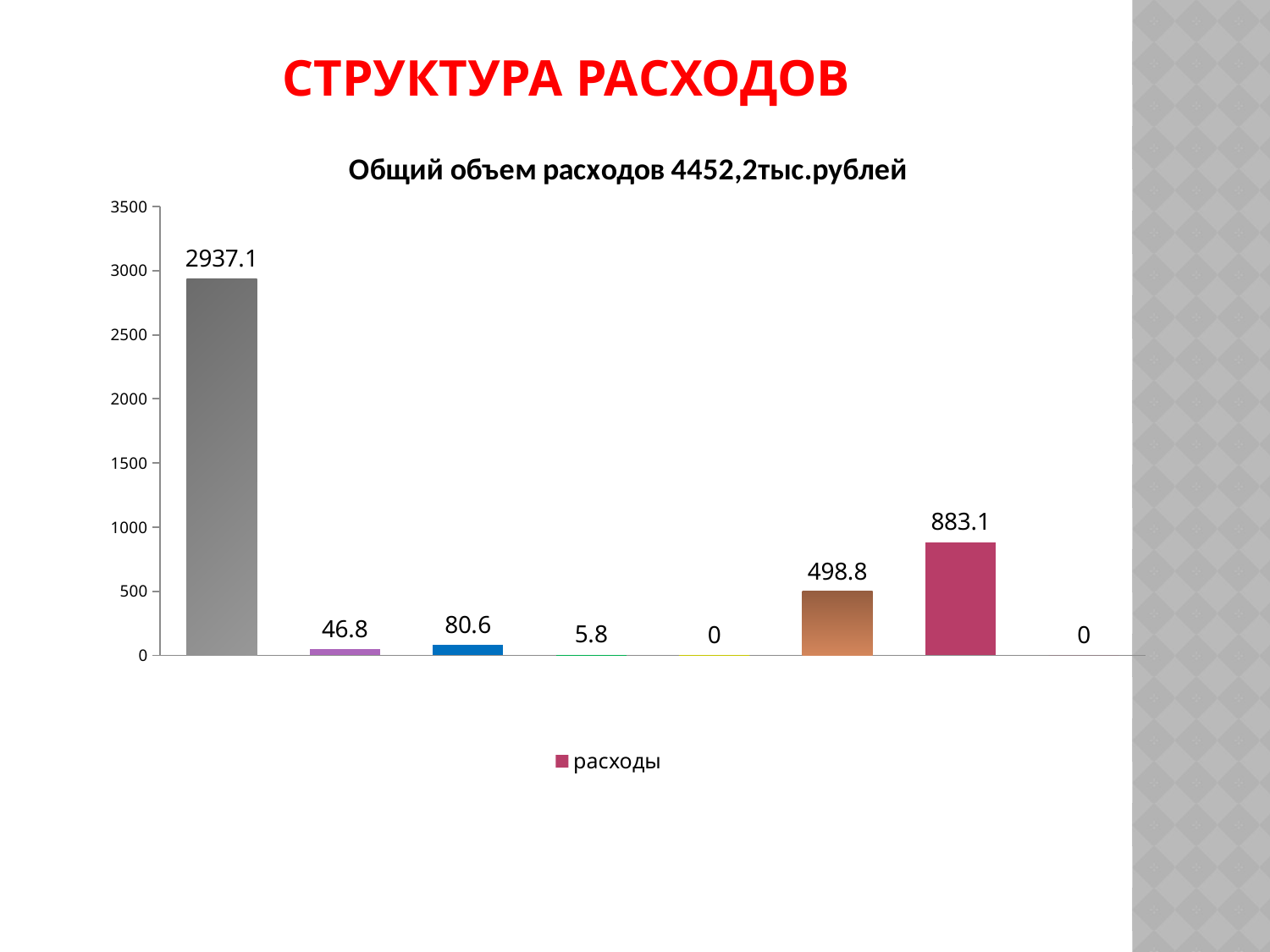
What is the value of the brown bar? 498.8 How many bars are plotted in the chart? 8 What is the value of the pink bar, the second bar from the right? 883.1 What kind of chart is shown on the slide? bar chart What is the value of the first bar from the left (the grey bar)? 2937.1 How many bars have a value of 0? 2 Which is larger, the blue bar or the purple bar? the blue bar How many series does the legend list? 1 What is the legend entry shown below the chart? расходы What is the value of the tallest bar in the chart? 2937.1 What is the difference between the pink bar (883.1) and the brown bar (498.8)? 384.3 Is the value of the pink bar greater or less than 1000? less